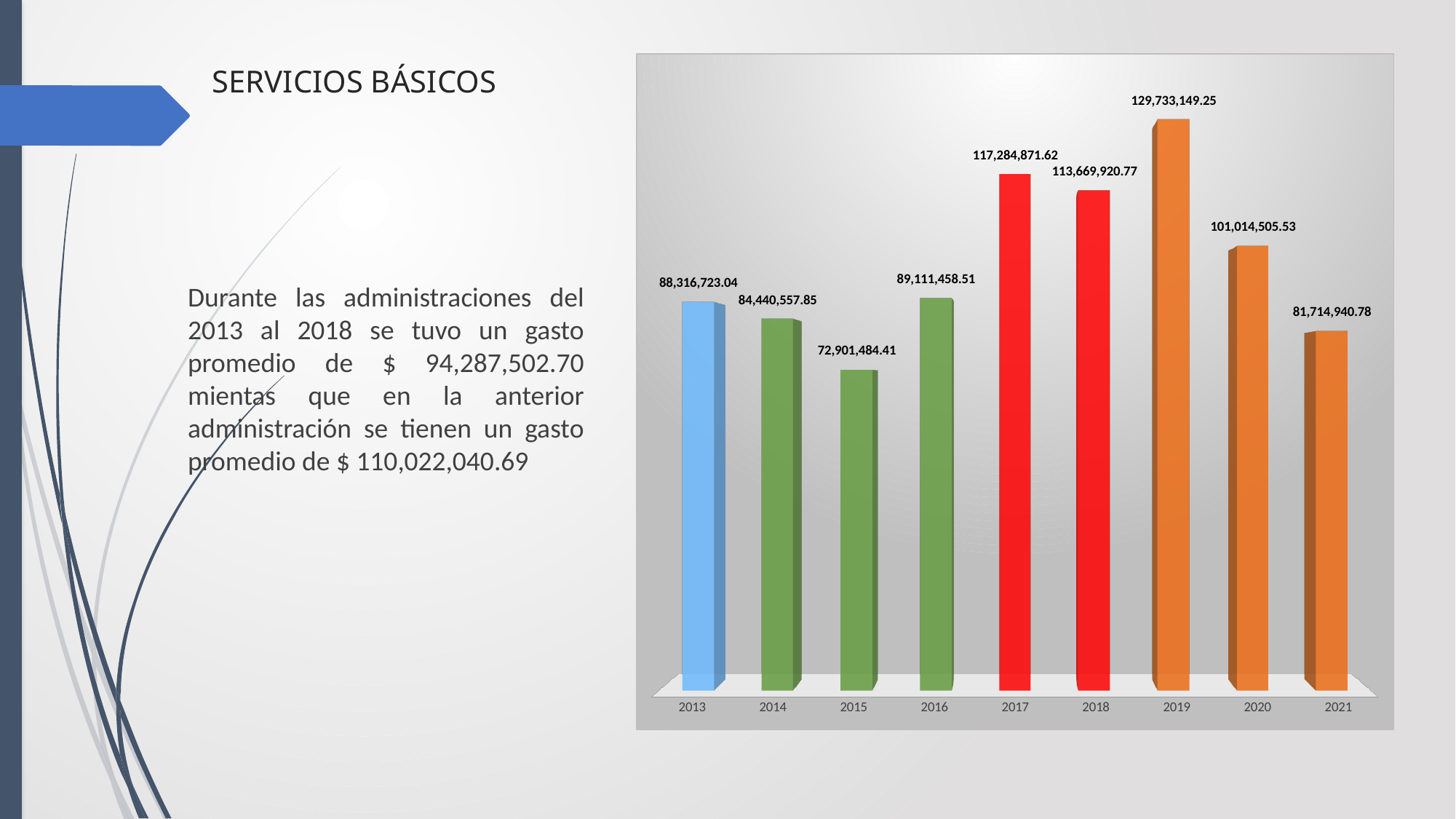
Which is larger, the value for 2017 or the value for 2018? 2017 Which year has the highest value? 2019 What is the difference between the values for 2019 and 2021? 48,018,208.47 What is the difference between the values for 2016 and 2015? 16,209,974.10 What is the value shown for 2015? 72,901,484.41 What kind of chart is shown on the slide? Bar chart Which year has the lowest value? 2015 What colour are the bars for 2017 and 2018? Red What is the value shown for 2021? 81,714,940.78 What is the value shown for 2019? 129,733,149.25 How many years are shown on the x axis? 9 What is the value shown for 2013? 88,316,723.04